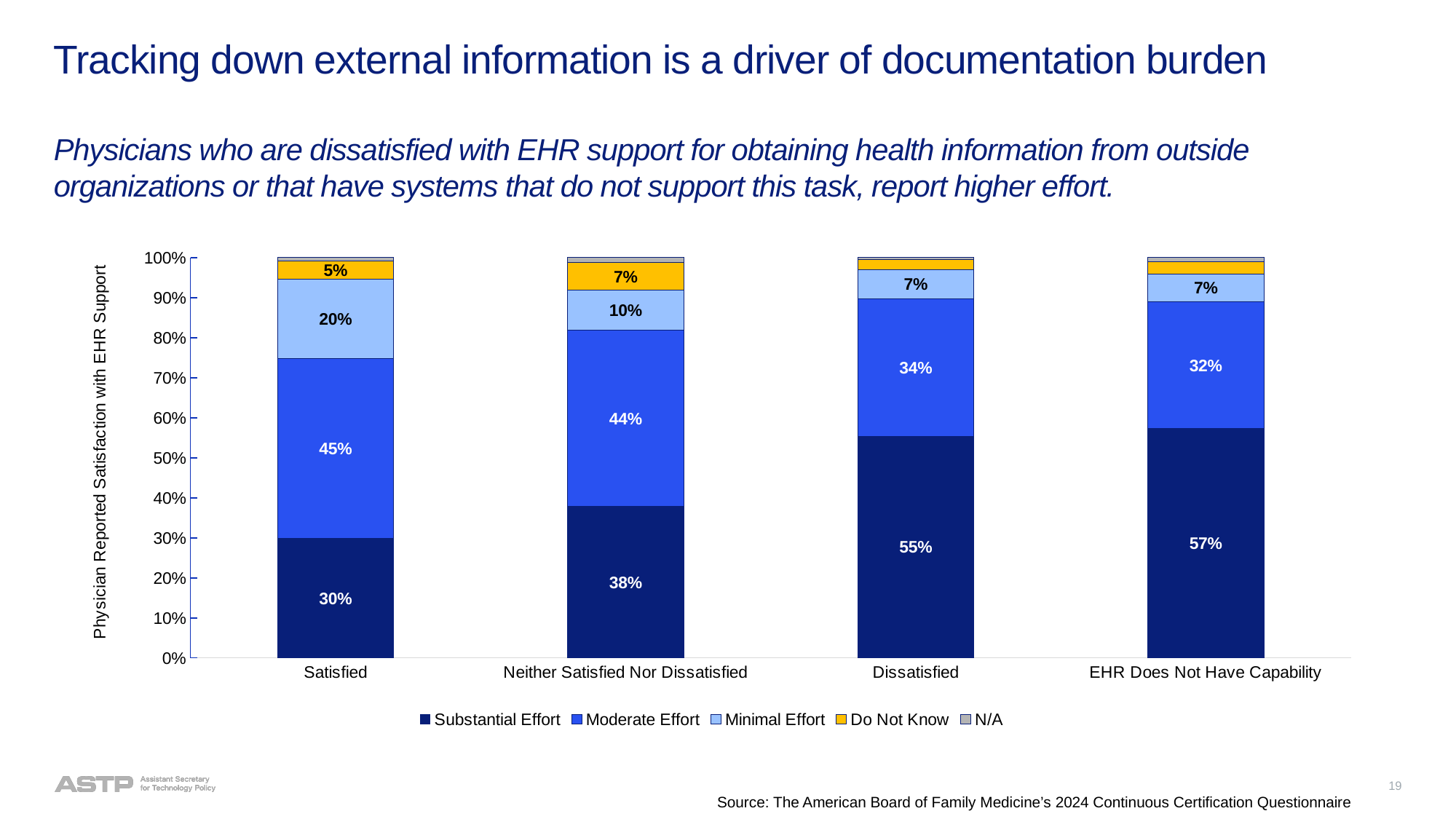
What kind of chart is shown on the slide? Stacked bar chart What is the Moderate Effort value for the Neither Satisfied Nor Dissatisfied category? 44% What is the difference between the Substantial Effort values for EHR Does Not Have Capability and Satisfied? 27% How many categories are shown on the x axis of the chart? 4 What is the Minimal Effort value for the Dissatisfied category? 7% Which category has the lowest Substantial Effort value? Satisfied How many series does the chart's legend list? 5 Which is larger: the Moderate Effort value for Satisfied or for Dissatisfied? Satisfied Which category has the highest Substantial Effort value? EHR Does Not Have Capability What is the Do Not Know value for the Neither Satisfied Nor Dissatisfied category? 7% Does the Substantial Effort value rise or fall moving from Satisfied to EHR Does Not Have Capability along the x axis? Rise What is the Substantial Effort value for the Satisfied category? 30%